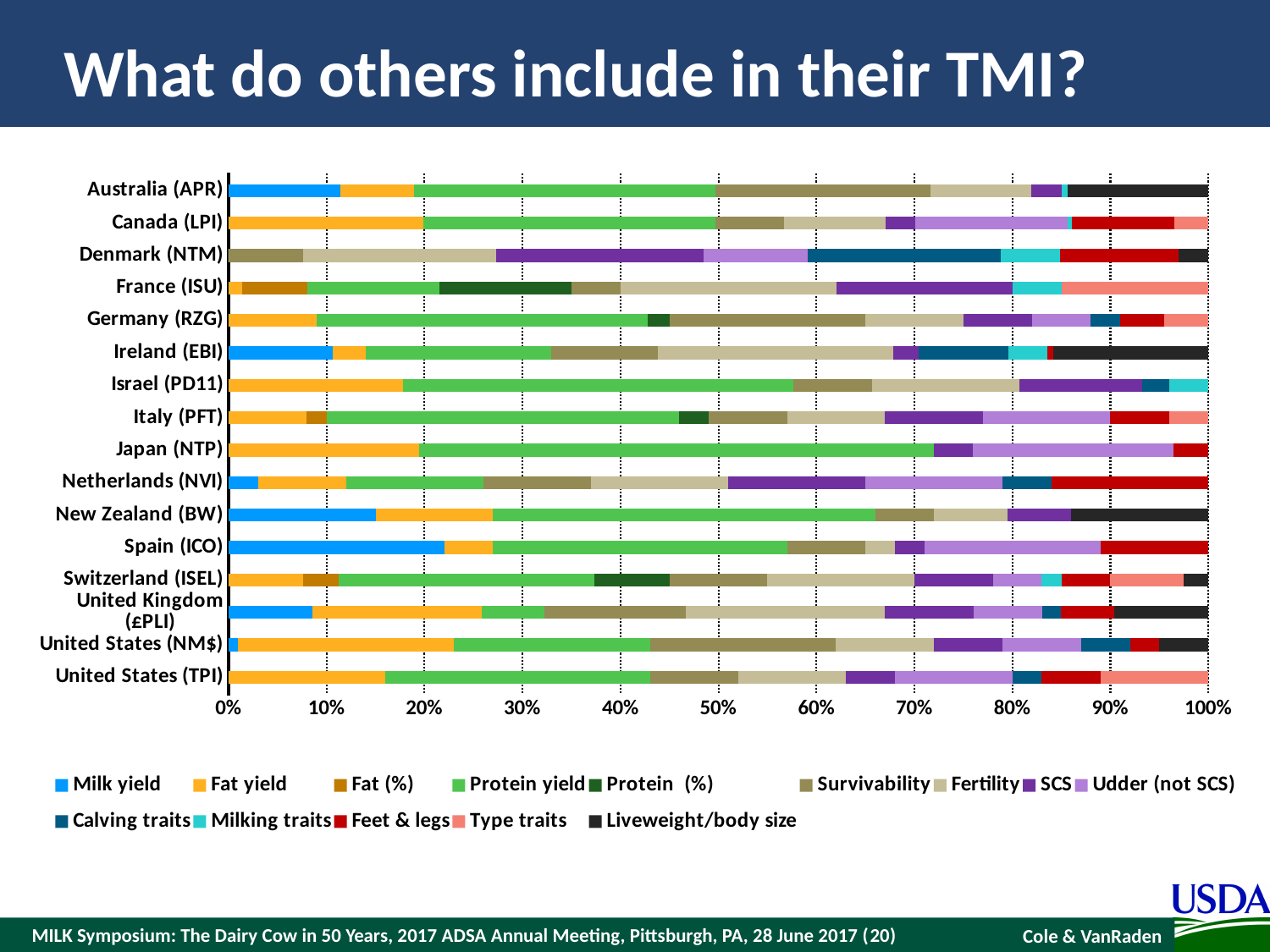
How many series does the chart legend list? 14 Is the Milk yield share for Netherlands (NVI) greater or less than 10%? less Which series is listed last in the chart legend? Liveweight/body size Which index has the largest Milk yield share in its bar? Spain (ICO) Which has a larger Milk yield share, Spain (ICO) or Australia (APR)? Spain (ICO) Which index has the largest Protein yield share in its bar? Japan (NTP) What is the title of the slide containing the chart? What do others include in their TMI? Is the Milk yield share for Spain (ICO) greater or less than 20%? greater What kind of chart is shown on the slide? Stacked bar chart How many countries/indices are listed on the vertical axis of the chart? 16 What does each stacked bar in the chart total? 100% Is the Milk yield share for New Zealand (BW) greater or less than 10%? greater